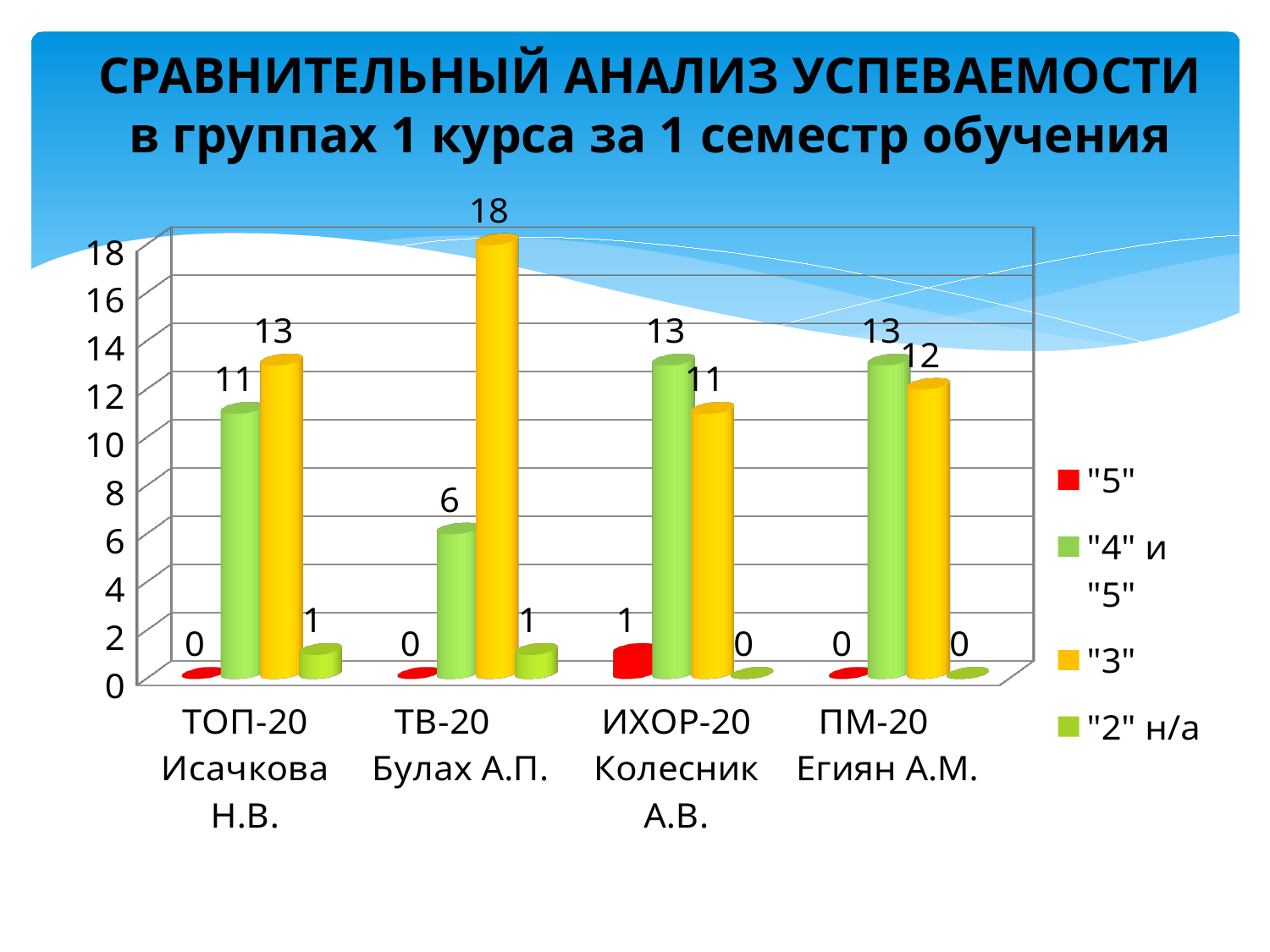
What colour represents the "3" series in the legend? Yellow For ПМ-20 Егиян А.М., which is larger: the "4" и "5" value or the "3" value? "4" и "5" What is the value of the "4" и "5" series for ТОП-20 Исачкова Н.В.? 11 Which group has the highest value in the "3" series? ТВ-20 Булах А.П. How many series does the legend list? 4 What is the value of the "5" series for ИХОР-20 Колесник А.В.? 1 How many groups are shown on the x axis? 4 What is the difference between the "3" value and the "4" и "5" value for ТВ-20 Булах А.П.? 12 What kind of chart is shown on the slide? Bar chart What is the value of the "2" н/а series for ПМ-20 Егиян А.М.? 0 What is the value of the "3" series for ТВ-20 Булах А.П.? 18 Which group has the lowest value in the "4" и "5" series? ТВ-20 Булах А.П.